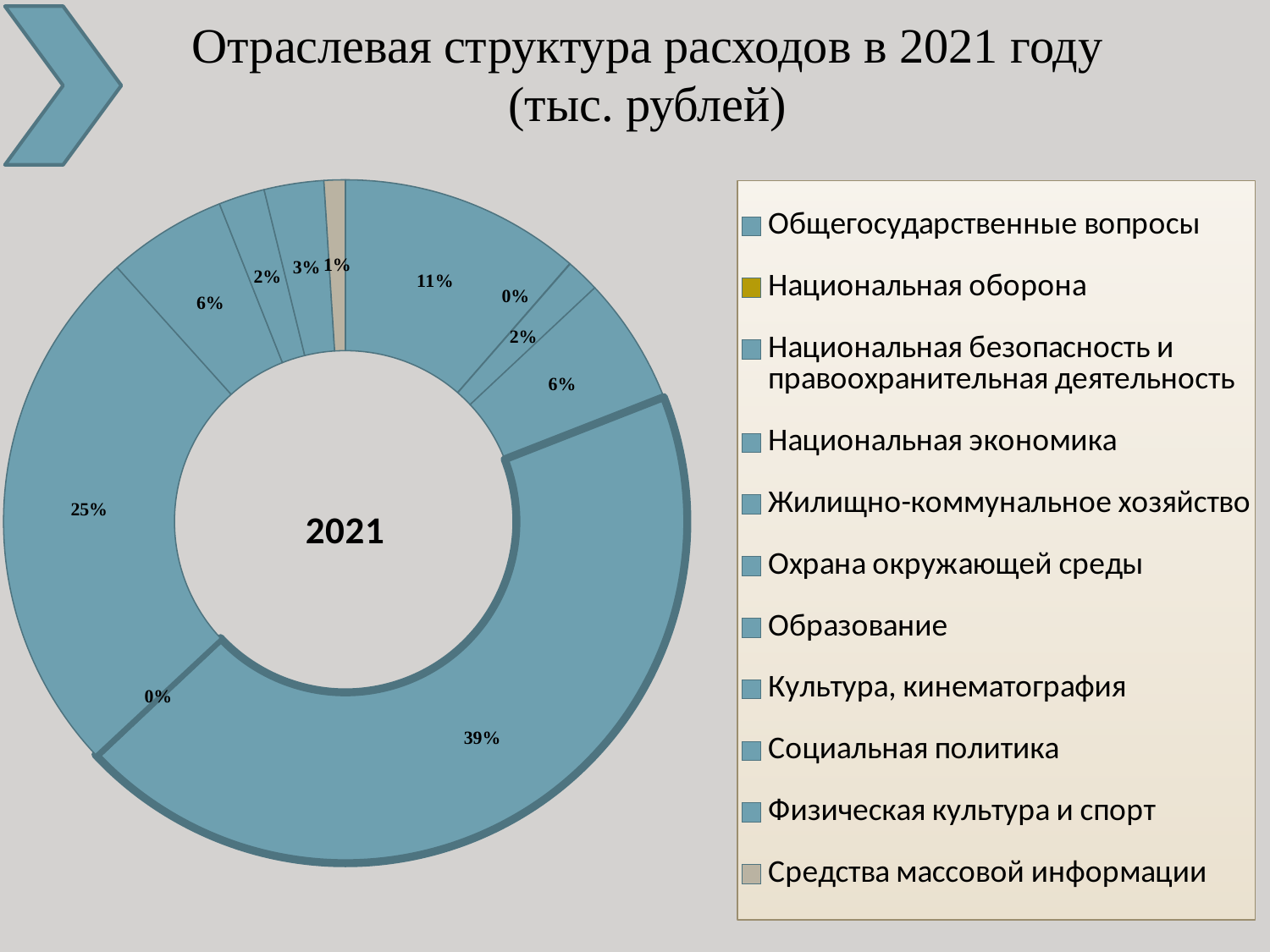
What share is shown for the slice labelled 25%, which corresponds to Образование? 25% What year is written in the centre of the doughnut chart? 2021 Which legend entry is shown with a gold/yellow colour? Национальная оборона How many categories does the legend list? 11 What is the difference between the largest slice (39%) and the 25% slice? 14% What is the largest share shown on the doughnut chart? 39% What share is shown for the beige slice, Средства массовой информации? 1% Which is larger: the 11% slice or the 25% slice? The 25% slice What kind of chart is shown on the slide? Doughnut (pie) chart How many slices are labelled 0% on the chart? 2 What is the title of the chart on the slide? Отраслевая структура расходов в 2021 году (тыс. рублей) What is the combined share of the two slices labelled 6%? 12%